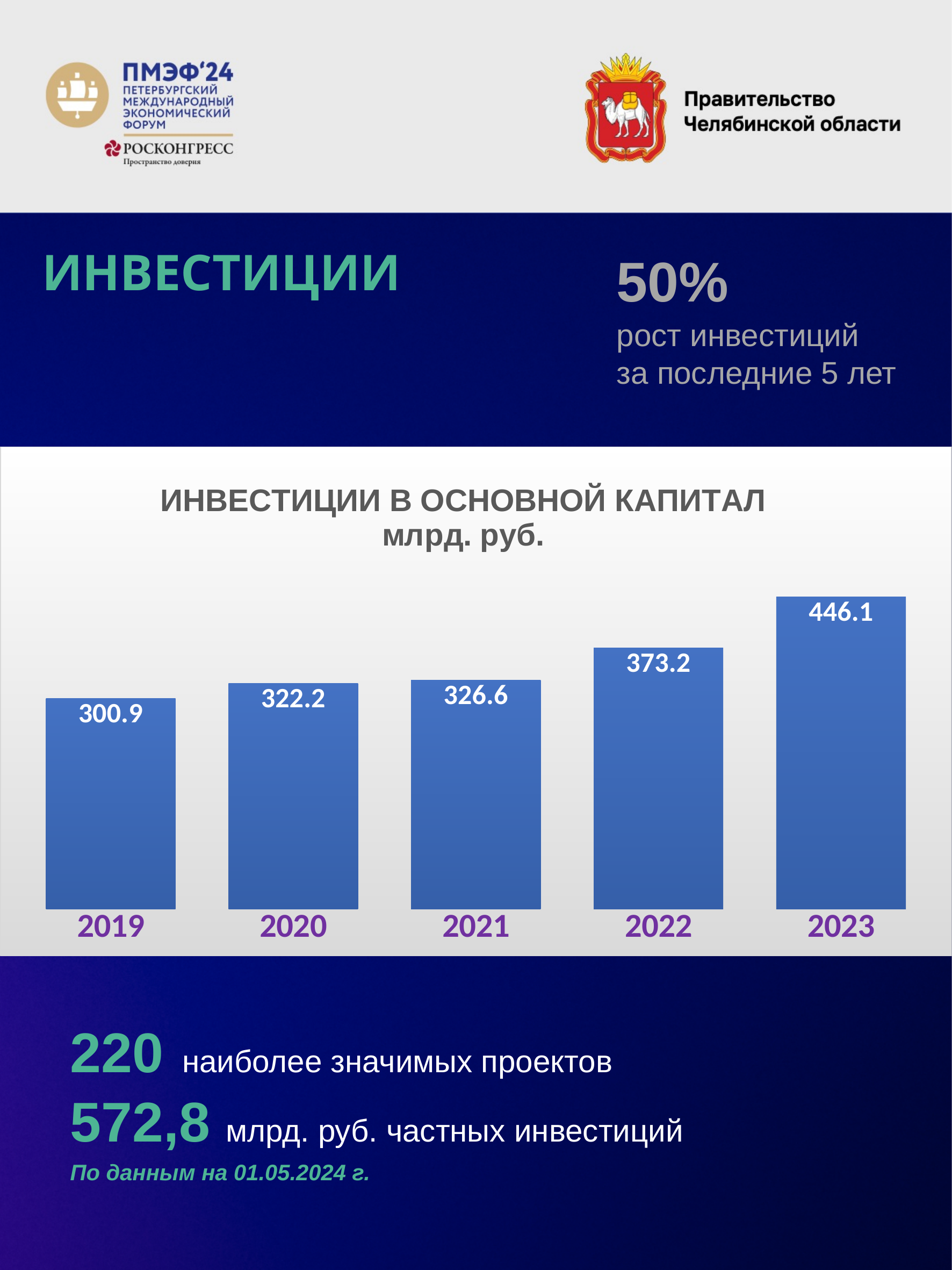
What is the difference between the values for 2023 and 2022? 72.9 What is the title of the chart? ИНВЕСТИЦИИ В ОСНОВНОЙ КАПИТАЛ млрд. руб. What kind of chart is shown? bar chart How many years are shown in the chart? 5 Which is larger, the value for 2022 or the value for 2021? 2022 What is the value for 2019? 300.9 Which year has the highest value? 2023 What is the value for 2023? 446.1 What is the difference between the values for 2020 and 2019? 21.3 Do the values rise or fall from 2019 to 2023? rise What is the value for 2021? 326.6 Which year has the lowest value? 2019